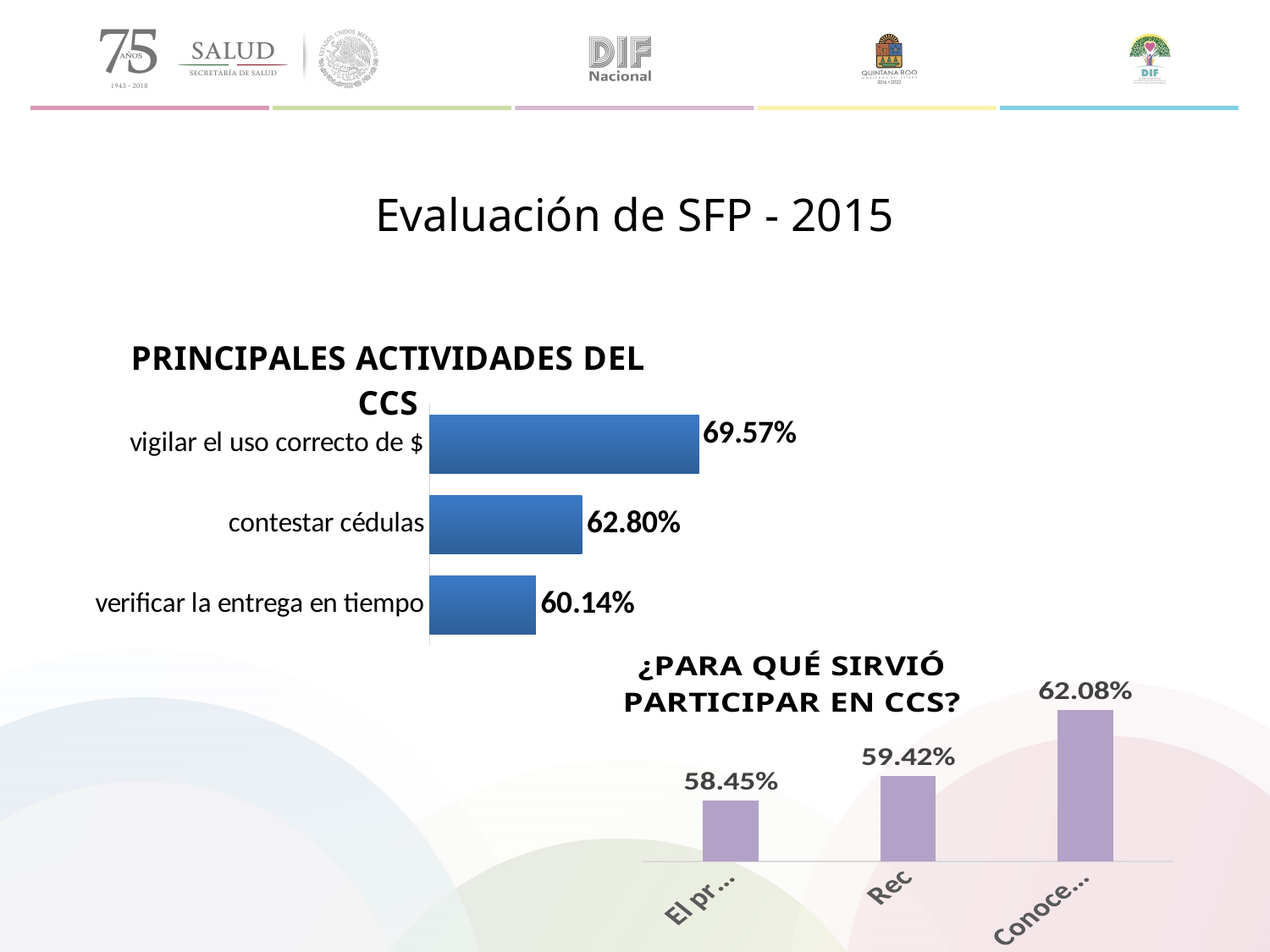
In the chart 'PRINCIPALES ACTIVIDADES DEL CCS', which is larger: 'contestar cédulas' or 'verificar la entrega en tiempo'? contestar cédulas What type of chart is 'PRINCIPALES ACTIVIDADES DEL CCS'? Bar chart In the chart 'PRINCIPALES ACTIVIDADES DEL CCS', what is the value for 'vigilar el uso correcto de $'? 69.57% In the chart 'PRINCIPALES ACTIVIDADES DEL CCS', which activity has the lowest value? verificar la entrega en tiempo In the chart 'PRINCIPALES ACTIVIDADES DEL CCS', what is the difference between 'vigilar el uso correcto de $' and 'contestar cédulas'? 6.77% In the chart '¿PARA QUÉ SIRVIÓ PARTICIPAR EN CCS?', do the values rise or fall from left to right? Rise In the chart 'PRINCIPALES ACTIVIDADES DEL CCS', what is the value for 'contestar cédulas'? 62.80% In the chart 'PRINCIPALES ACTIVIDADES DEL CCS', what is the value for 'verificar la entrega en tiempo'? 60.14% In the chart 'PRINCIPALES ACTIVIDADES DEL CCS', which activity has the highest value? vigilar el uso correcto de $ In the chart '¿PARA QUÉ SIRVIÓ PARTICIPAR EN CCS?', what is the highest value shown? 62.08% In the chart '¿PARA QUÉ SIRVIÓ PARTICIPAR EN CCS?', what is the lowest value shown? 58.45% How many categories are shown in the chart 'PRINCIPALES ACTIVIDADES DEL CCS'? 3